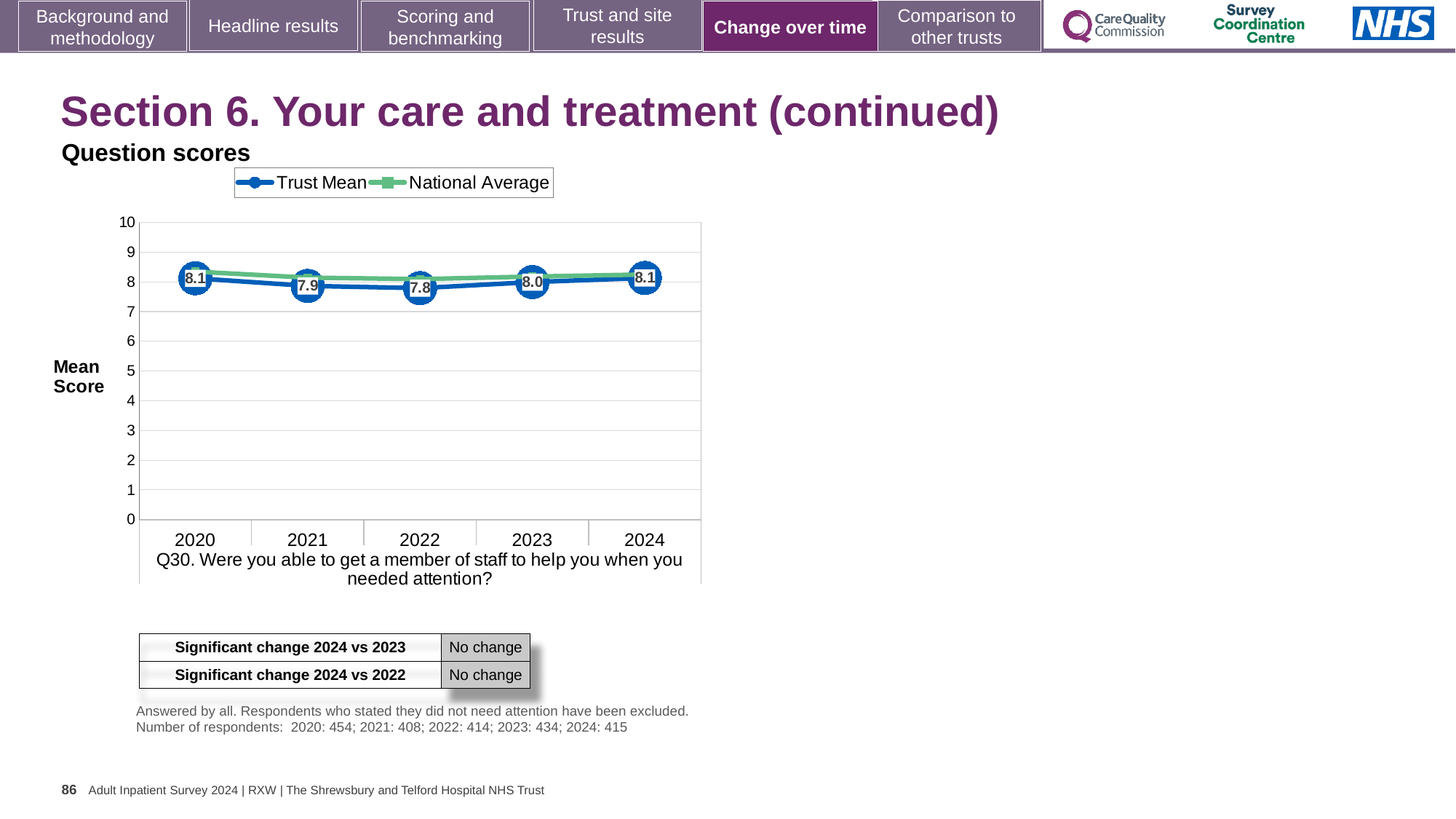
What is the Trust Mean score for 2022? 7.8 What is the Trust Mean score for 2024? 8.1 Is the Trust Mean score for 2021 greater or less than 9? less What is the Trust Mean score for 2020? 8.1 How many series does the legend list? 2 How many years are shown on the x axis? 5 What is the Trust Mean score for 2021? 7.9 Which year has the lowest Trust Mean score? 2022 Which question does the chart show scores for? Q30. Were you able to get a member of staff to help you when you needed attention? What is the difference between the Trust Mean scores for 2024 and 2022? 0.3 Which is larger, the Trust Mean score for 2023 or for 2022? 2023 What kind of chart is shown? line chart